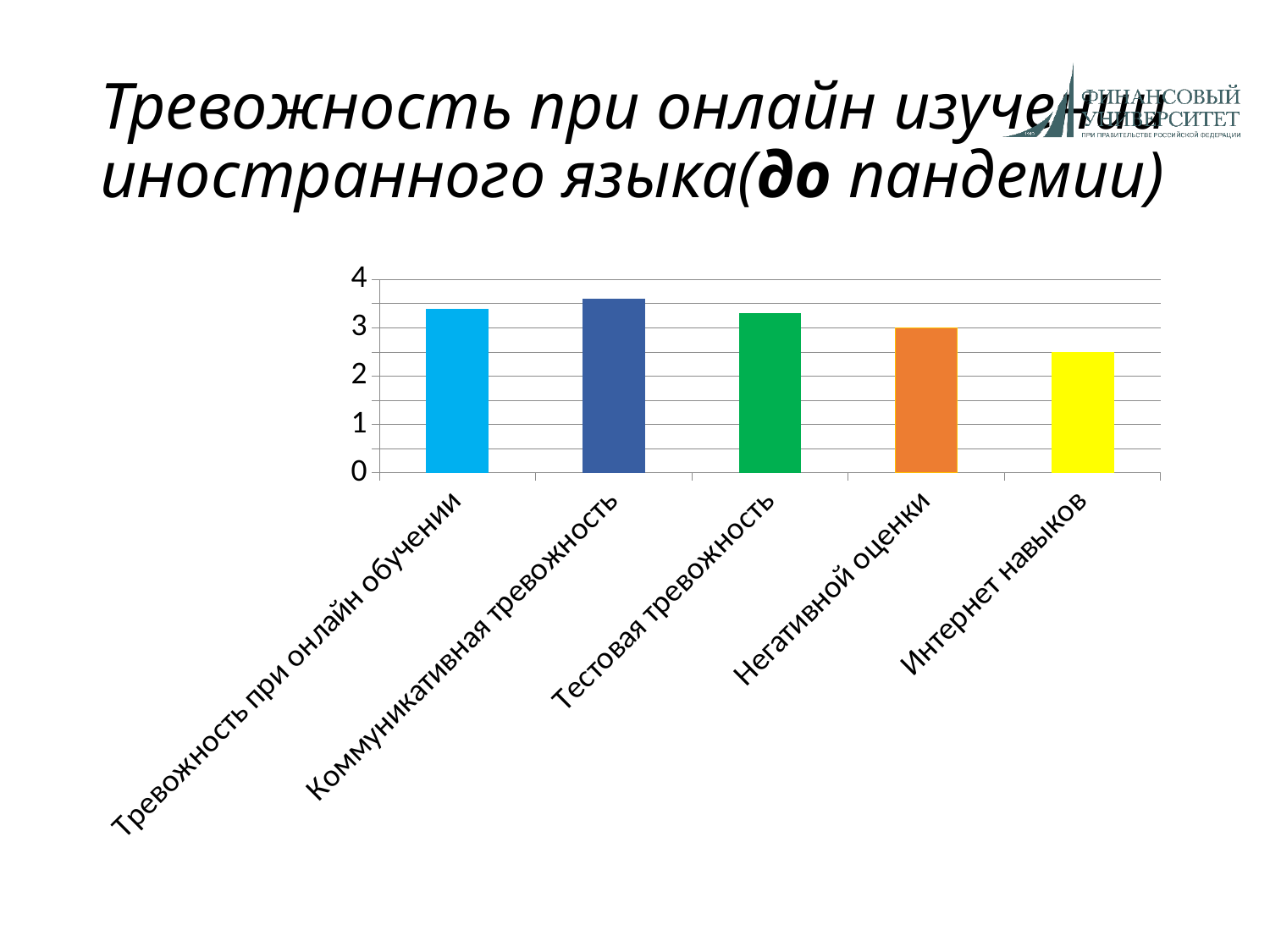
How many categories are plotted in the chart? 5 Which is larger, the value for Тревожность при онлайн обучении or the value for Интернет навыков? Тревожность при онлайн обучении Which category has the highest bar in the chart? Коммуникативная тревожность Is the value for Интернет навыков greater or less than 3? less Which is larger, the value for Коммуникативная тревожность or the value for Негативной оценки? Коммуникативная тревожность Is the value for Тестовая тревожность greater or less than 3? greater Which category has the lowest bar in the chart? Интернет навыков Is the value for Коммуникативная тревожность greater or less than 3? greater What colour is the bar for Интернет навыков? yellow What kind of chart is shown on the slide? bar chart What is the title of the slide containing the chart? Тревожность при онлайн изучении иностранного языка(до пандемии)